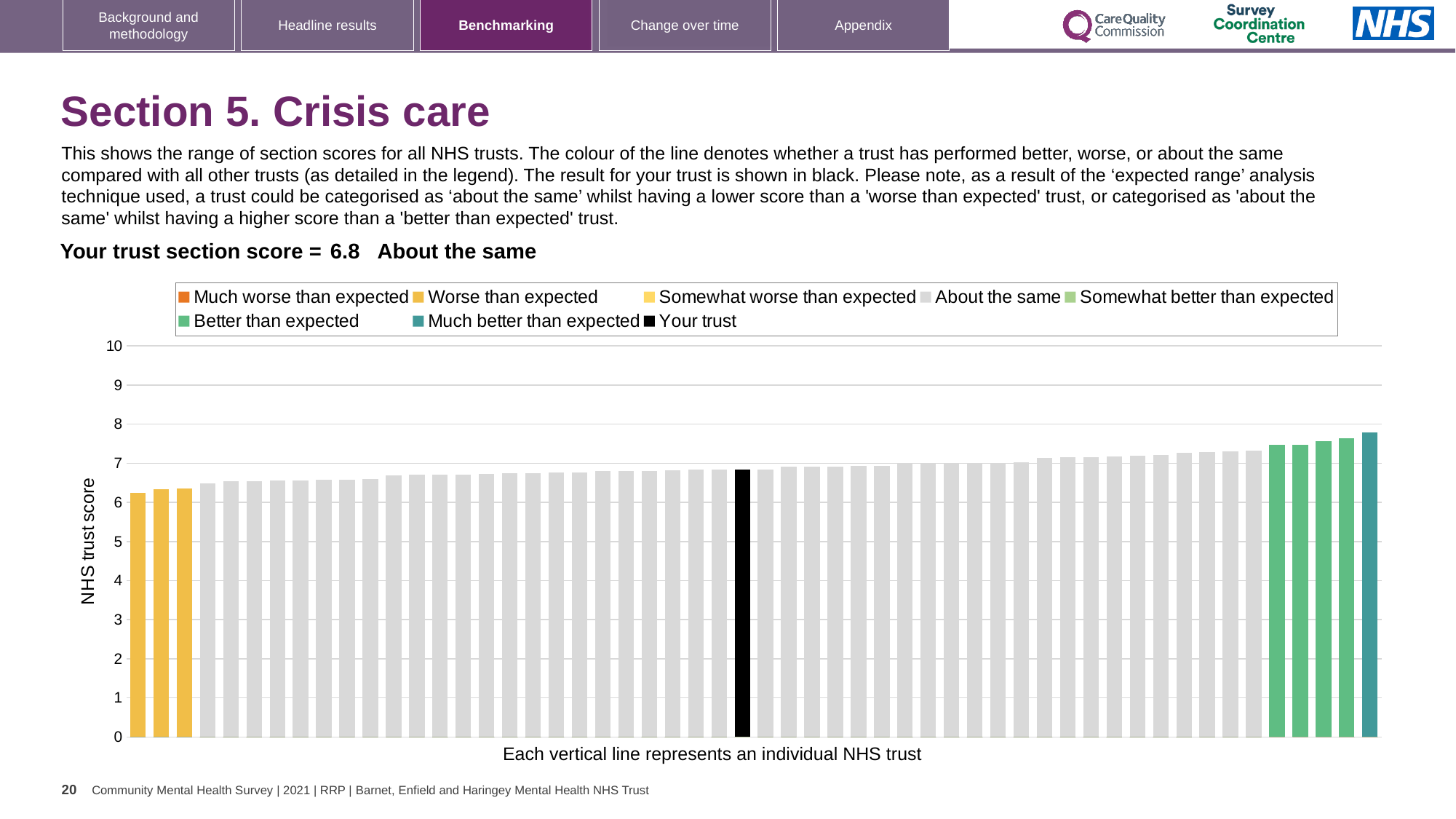
How many bars are coloured as 'Worse than expected' (yellow)? 3 What kind of chart is shown on the slide? bar chart Is the value of the shortest bar in the chart greater or less than 6? greater How many entries does the chart legend list? 8 How many bars are coloured as 'Better than expected' (green)? 4 What is the trust's section score for Crisis care shown on the slide? 6.8 Is the value of the tallest bar in the chart greater or less than 8? less What is the label on the vertical axis of the chart? NHS trust score How many bars are coloured as 'Much better than expected' (teal)? 1 Do the bar values rise or fall moving from left to right along the x axis? rise Which category is the trust's section score placed in, according to the text above the chart? About the same Is the value for the black 'Your trust' bar greater or less than 6? greater